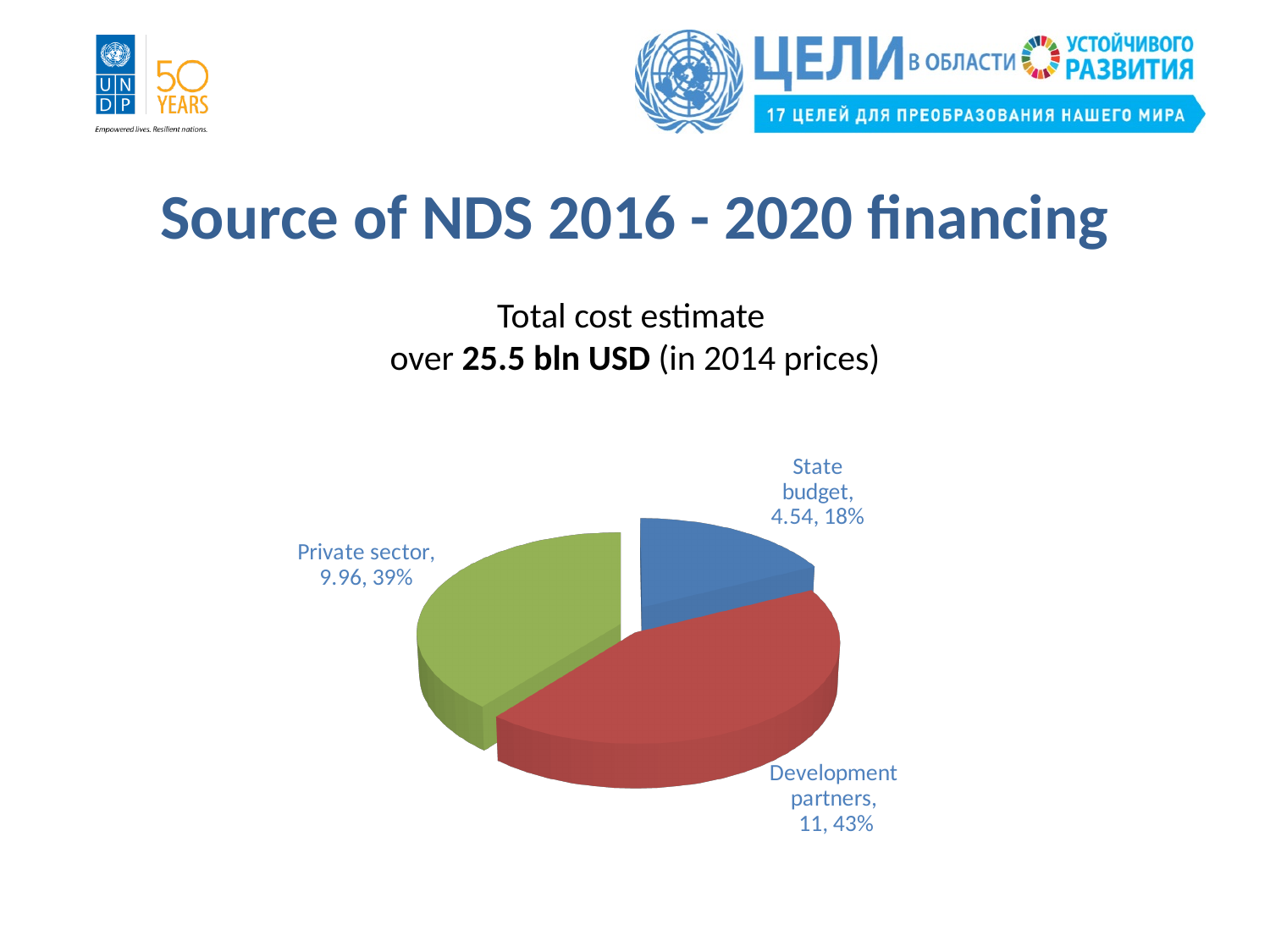
Which is larger, the value for Private sector or the value for State budget? Private sector Which category has the largest slice? Development partners What share of the pie does Development partners represent? 43% What is the difference between the values for Development partners and Private sector? 1.04 How many slices does the pie chart have? 3 What colour is the Private sector slice? green Which category has the smallest slice? State budget What is the value for Private sector? 9.96 What share of the pie does State budget represent? 18% What kind of chart is shown on the slide? pie chart What is the value for State budget? 4.54 What is the value for Development partners? 11